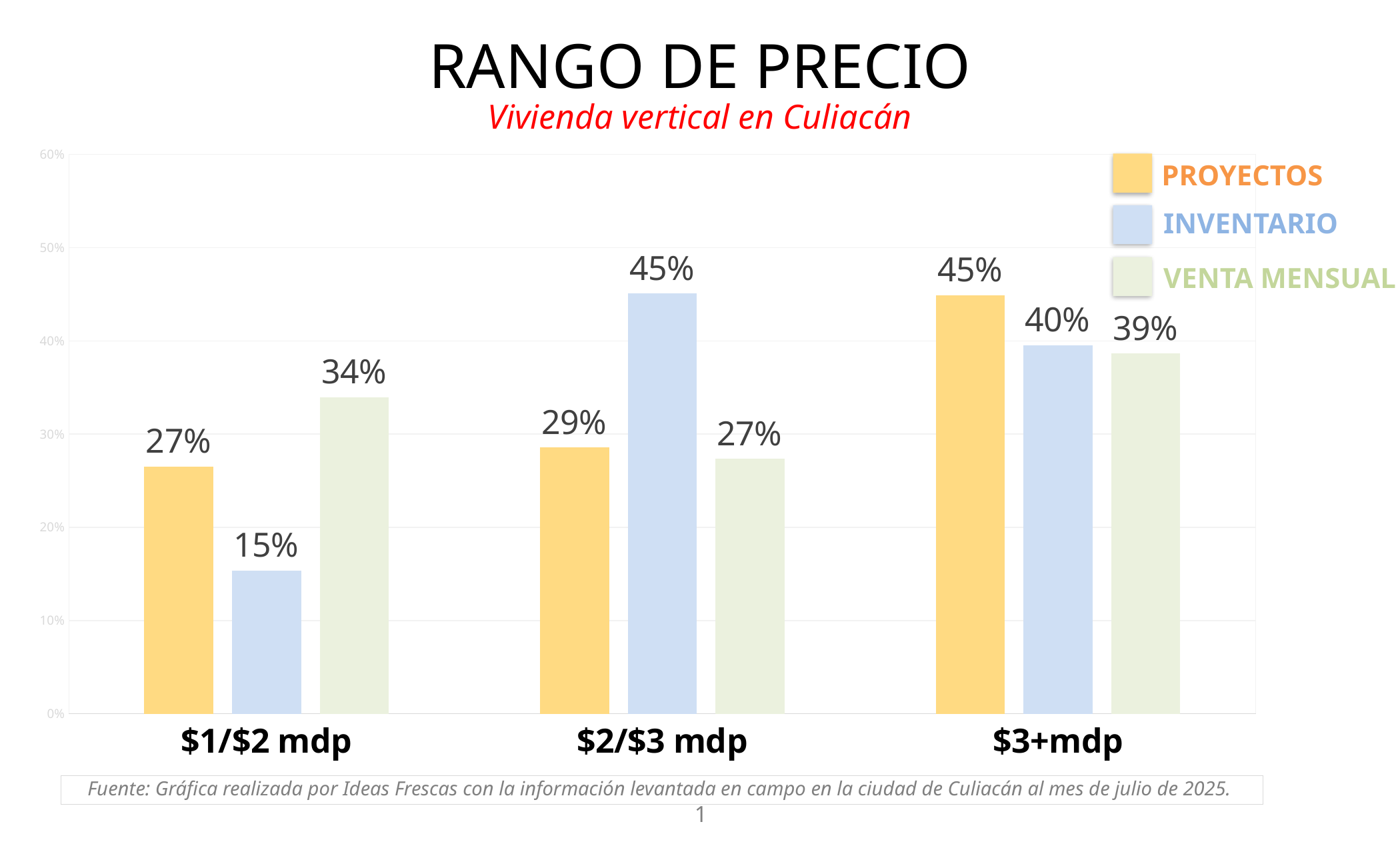
Is the VENTA MENSUAL value for $2/$3 mdp greater or less than 30%? less How many series does the legend list? 3 What is the PROYECTOS value for the $1/$2 mdp price range? 27% What is the difference between the INVENTARIO values for $2/$3 mdp and $1/$2 mdp? 30% Which price range has the lowest INVENTARIO value? $1/$2 mdp What kind of chart is shown on the slide? bar chart What is the INVENTARIO value for the $2/$3 mdp price range? 45% Which is larger for the $1/$2 mdp range: PROYECTOS or VENTA MENSUAL? VENTA MENSUAL How many price range categories are shown on the x axis? 3 Which series is shown in orange in the legend? PROYECTOS What is the VENTA MENSUAL value for the $3+mdp price range? 39% Which price range has the highest PROYECTOS value? $3+mdp